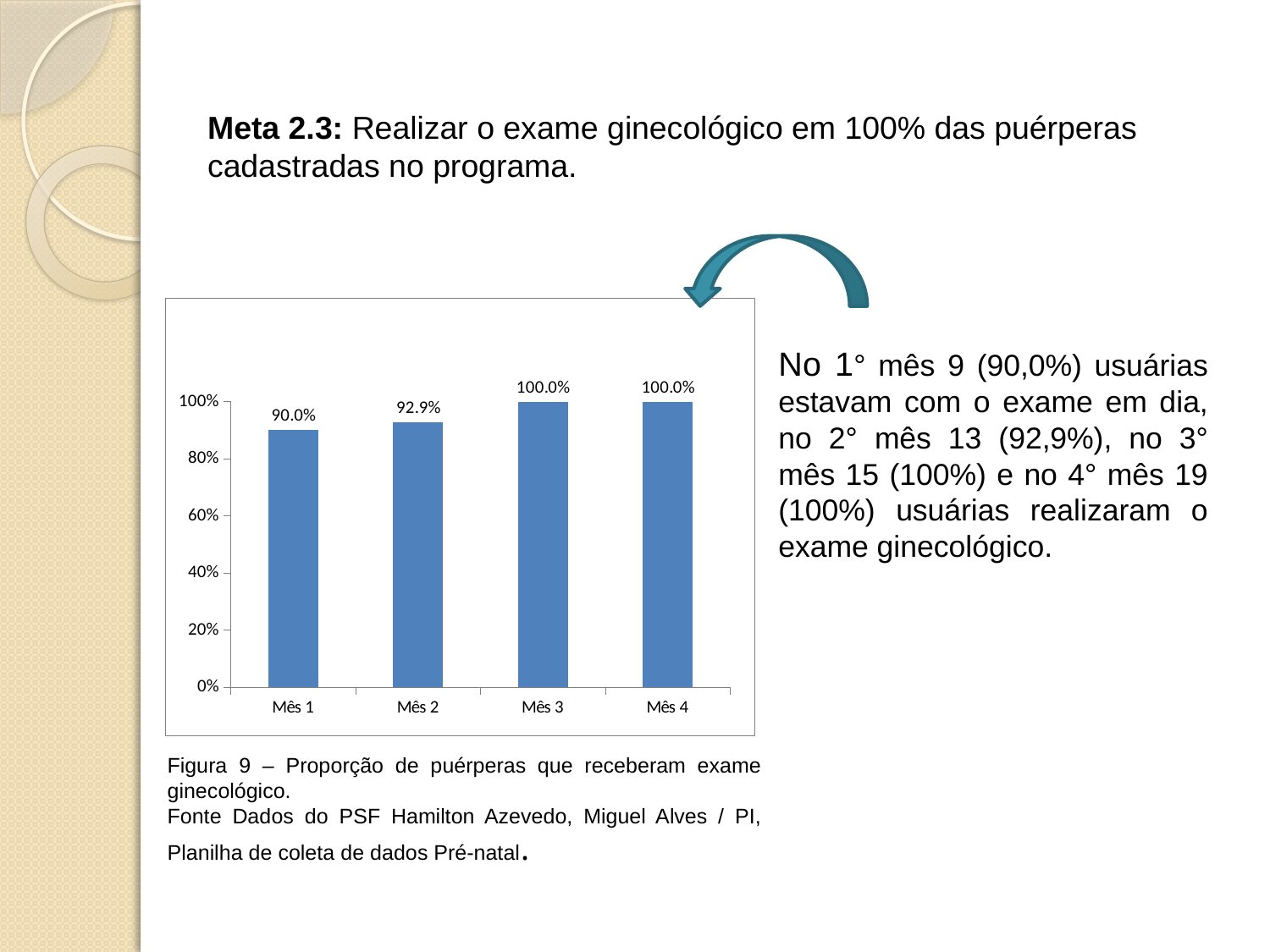
What is the difference between the values for Mês 3 and Mês 2? 7.1% Do the values rise or fall from Mês 1 to Mês 4? Rise What is the value for Mês 4? 100.0% What is the difference between the values for Mês 2 and Mês 1? 2.9% What is the value for Mês 3? 100.0% How many months are shown on the x axis? 4 Is the value for Mês 1 greater or less than 80%? greater Which month has the lowest value? Mês 1 What is the value for Mês 2? 92.9% Which is larger, the value for Mês 1 or the value for Mês 2? Mês 2 What kind of chart is shown on the slide? Bar chart What is the value for Mês 1? 90.0%